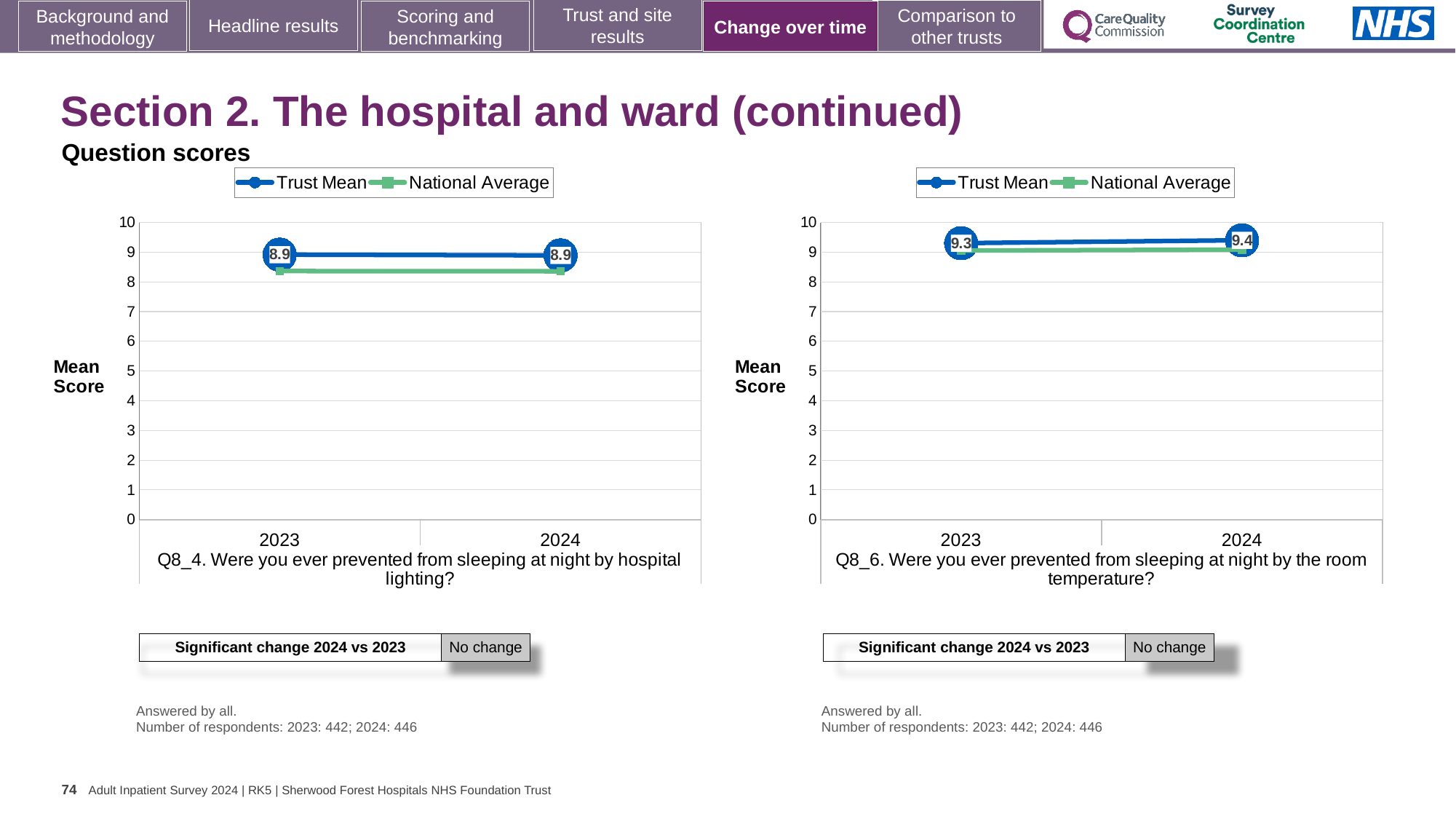
What kind of chart is the left chart (Q8_4, hospital lighting)? line chart How many years are plotted on the x axis of the left chart (Q8_4, hospital lighting)? 2 In the left chart (Q8_4, hospital lighting), is the National Average for 2024 greater or less than 9? less In the right chart (Q8_6, room temperature), what is the Trust Mean for 2023? 9.3 In the left chart (Q8_4, hospital lighting), what is the Trust Mean for 2023? 8.9 In the right chart (Q8_6, room temperature), does the Trust Mean rise or fall from 2023 to 2024? rise In the right chart (Q8_6, room temperature), what is the Trust Mean for 2024? 9.4 In the left chart (Q8_4, hospital lighting), which is higher in 2023, the Trust Mean or the National Average? Trust Mean How many series does the legend of the right chart (Q8_6, room temperature) list? 2 In the left chart (Q8_4, hospital lighting), what is the Trust Mean for 2024? 8.9 In the right chart (Q8_6, room temperature), by how much did the Trust Mean change from 2023 to 2024? 0.1 What does the 'Significant change 2024 vs 2023' box below the right chart (Q8_6, room temperature) say? No change